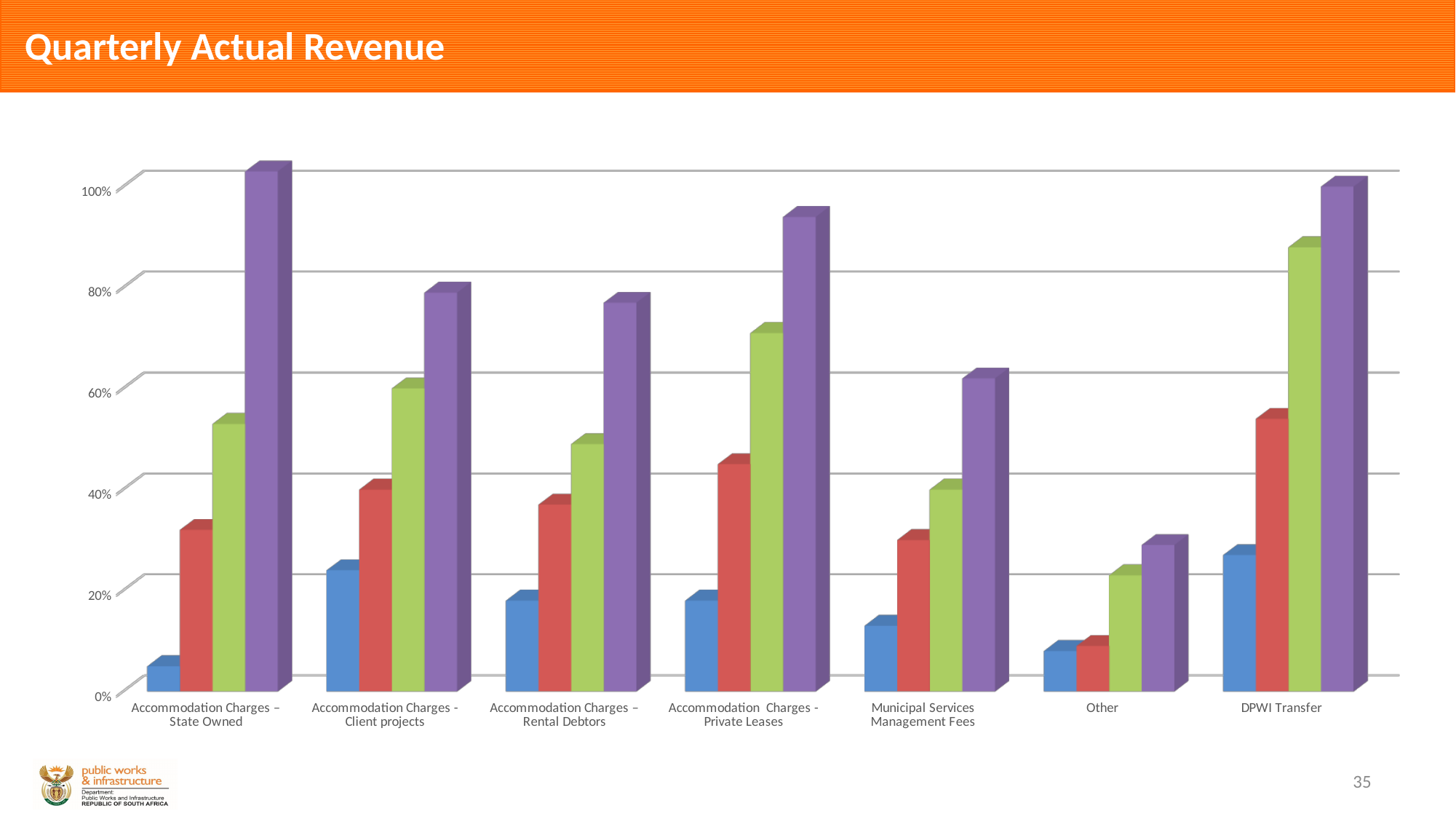
Which category has the highest green bar? DPWI Transfer How many categories are shown along the x axis of the chart? 7 Is the red bar for DPWI Transfer greater or less than 40%? greater Is the purple bar for Municipal Services Management Fees greater or less than 40%? greater How many bars are plotted for each category in the chart? 4 Which category has the lowest purple bar? Other Is the green bar for DPWI Transfer greater or less than 80%? greater Which category has the lowest red bar? Other What kind of chart is shown on the slide? bar chart What is the title of the slide containing the chart? Quarterly Actual Revenue